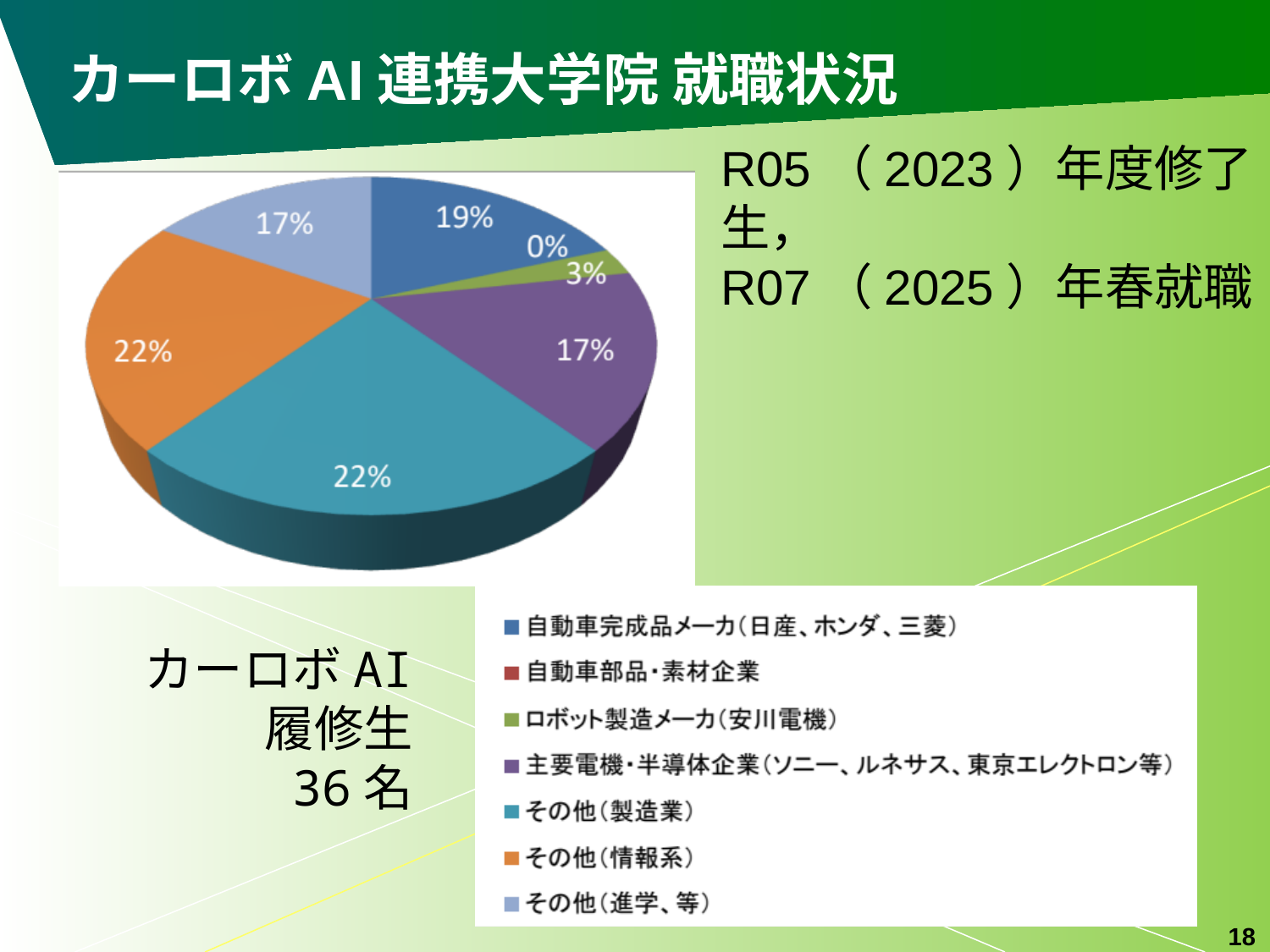
What is the difference between the share of 自動車完成品メーカ(日産、ホンダ、三菱) and the share of ロボット製造メーカ(安川電機)? 16% What kind of chart is shown on the slide? pie chart How many categories does the legend list? 7 What share of the pie does 自動車完成品メーカ(日産、ホンダ、三菱) have? 19% Which has the larger share, その他(情報系) or その他(進学、等)? その他(情報系) Which has the larger share, 自動車完成品メーカ(日産、ホンダ、三菱) or 主要電機・半導体企業(ソニー、ルネサス、東京エレクトロン等)? 自動車完成品メーカ(日産、ホンダ、三菱) Which category has the smallest share of the pie? 自動車部品・素材企業 What share of the pie does その他(進学、等) have? 17% What share of the pie does その他(製造業) have? 22% What colour is the slice for その他(情報系)? orange